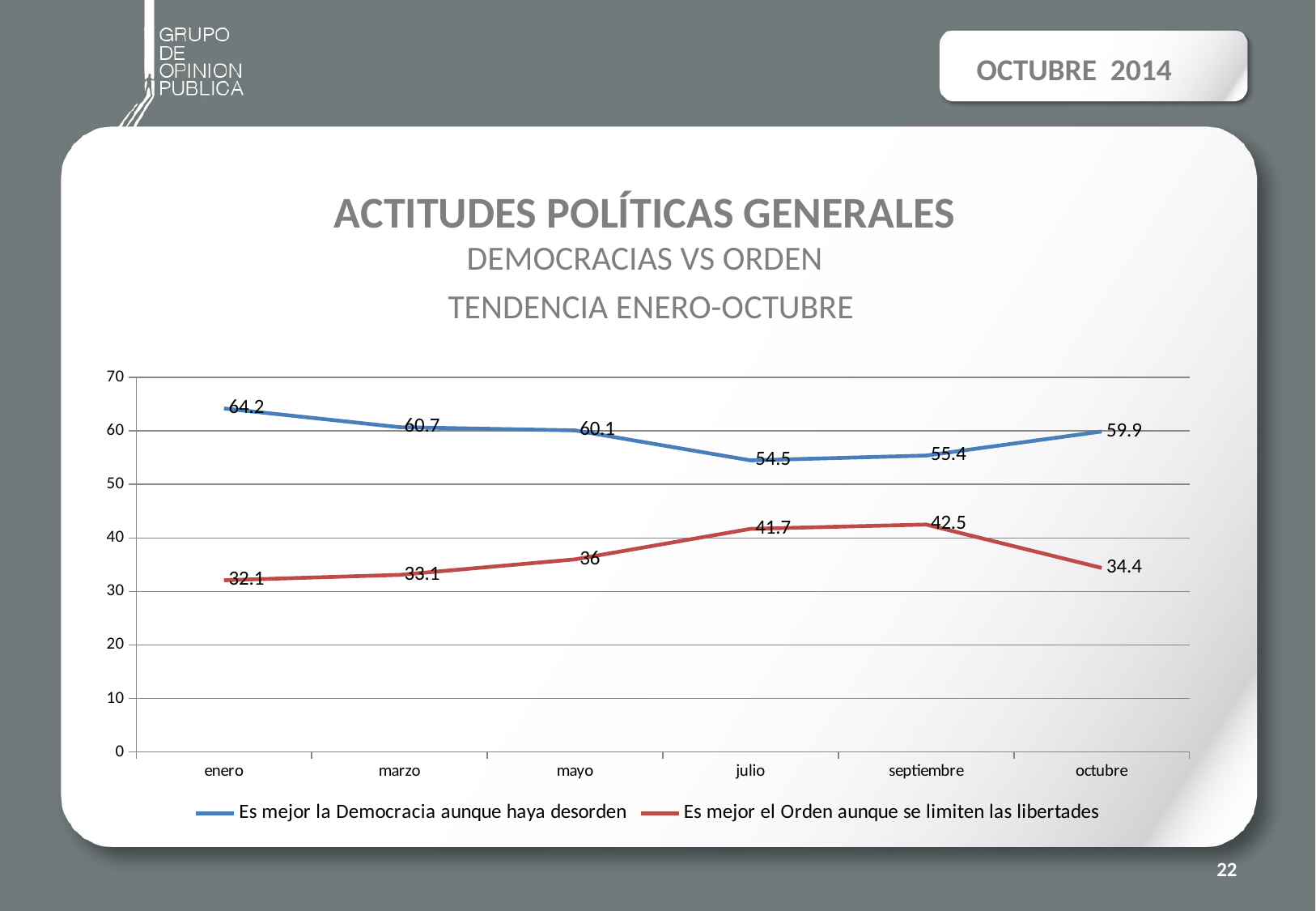
In which month is 'Es mejor el Orden aunque se limiten las libertades' highest? septiembre How many series does the legend list? 2 What is the value for 'Es mejor el Orden aunque se limiten las libertades' in septiembre? 42.5 How many months are shown on the x axis? 6 Does 'Es mejor el Orden aunque se limiten las libertades' rise or fall from enero to septiembre? rise What is the difference between the two series in octubre? 25.5 Is the value for 'Es mejor la Democracia aunque haya desorden' in marzo greater or less than 50? greater What kind of chart is shown? line chart Which is larger: 'Es mejor el Orden aunque se limiten las libertades' in julio or in octubre? julio What is the value for 'Es mejor la Democracia aunque haya desorden' in enero? 64.2 In which month is 'Es mejor la Democracia aunque haya desorden' lowest? julio What is the value for 'Es mejor el Orden aunque se limiten las libertades' in mayo? 36